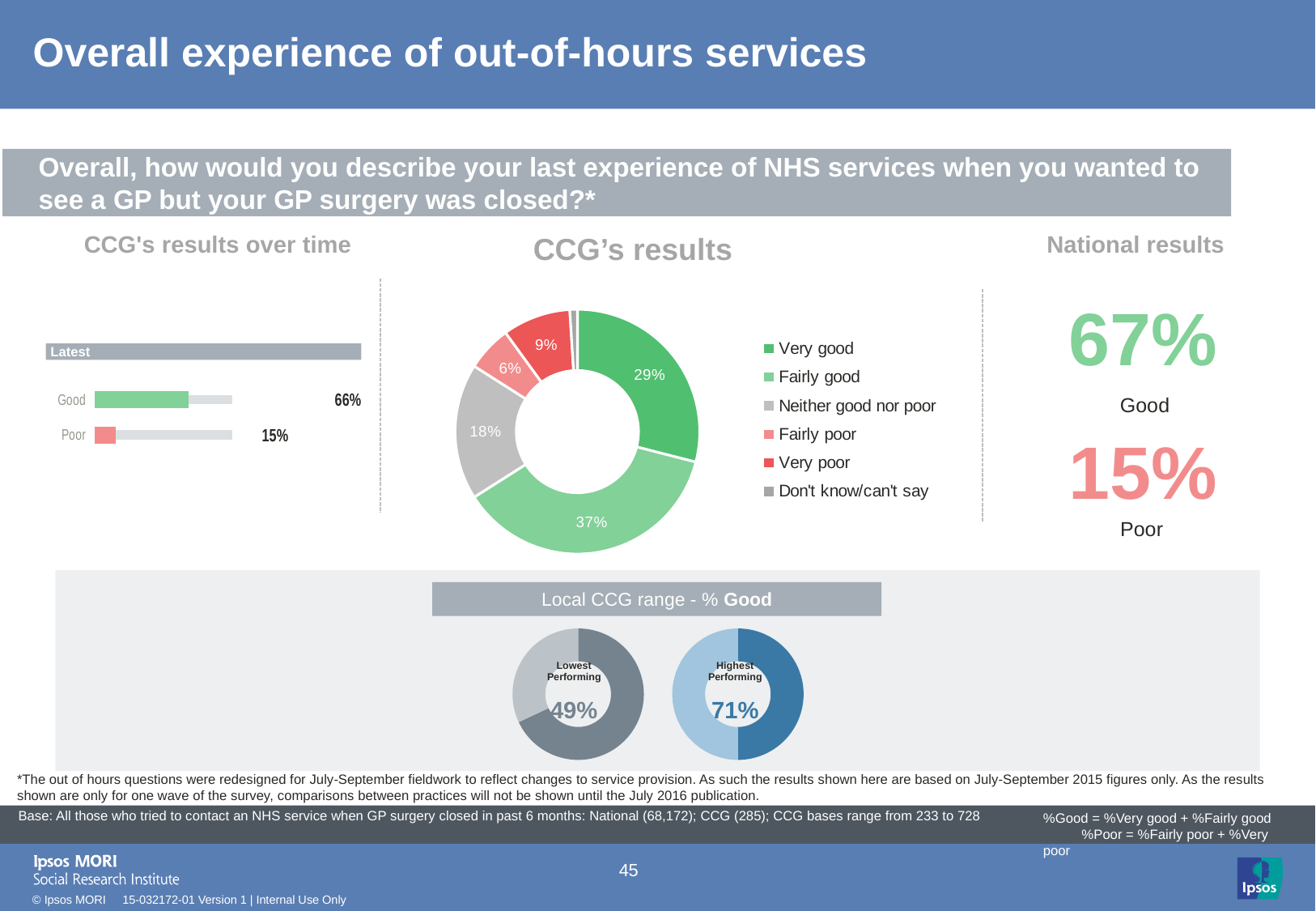
How many entries does the legend of the CCG's results donut chart list? 6 In the Local CCG range - % Good section, what is the Highest Performing value? 71% In the CCG's results donut chart, is the Very poor share larger or smaller than the Fairly poor share? larger In the CCG's results donut chart, what is the difference between the Fairly good and Very good shares? 8% In the CCG's results donut chart, what percentage said Very poor? 9% In the CCG's results donut chart, which labelled category has the smallest share? Fairly poor In the CCG's results donut chart, what percentage said their experience was Very good? 29% In the CCG's results donut chart, what percentage said Neither good nor poor? 18% In the CCG's results donut chart, what percentage said their experience was Fairly good? 37% In the CCG's results over time chart, what is the Latest value for Good? 66% In the CCG's results over time chart, what is the Latest value for Poor? 15% In the CCG's results donut chart, which labelled category has the largest share? Fairly good